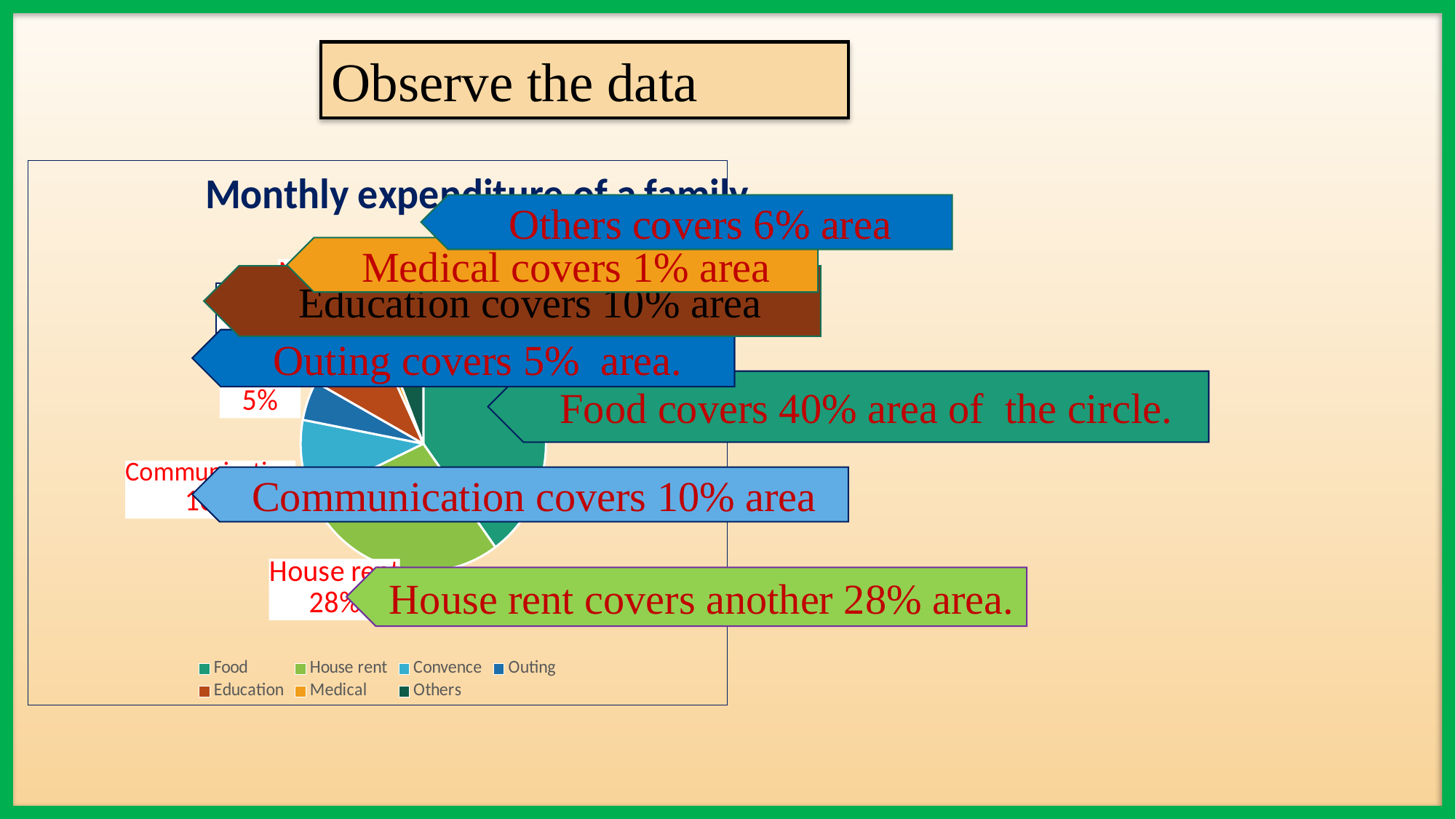
What percentage of the monthly expenditure does Outing cover? 5% What percentage of the monthly expenditure does Medical cover? 1% What kind of chart is shown on the slide? pie chart What percentage of the monthly expenditure does House rent cover? 28% What percentage of the monthly expenditure does Food cover? 40% What percentage of the monthly expenditure does Education cover? 10% How many percentage points larger is the Food share than the House rent share? 12% What percentage of the monthly expenditure does Others cover? 6% Which category covers the largest share of the pie? Food How many entries does the chart legend list? 7 What is the title of the chart? Monthly expenditure of a family Which category covers the smallest share of the pie? Medical